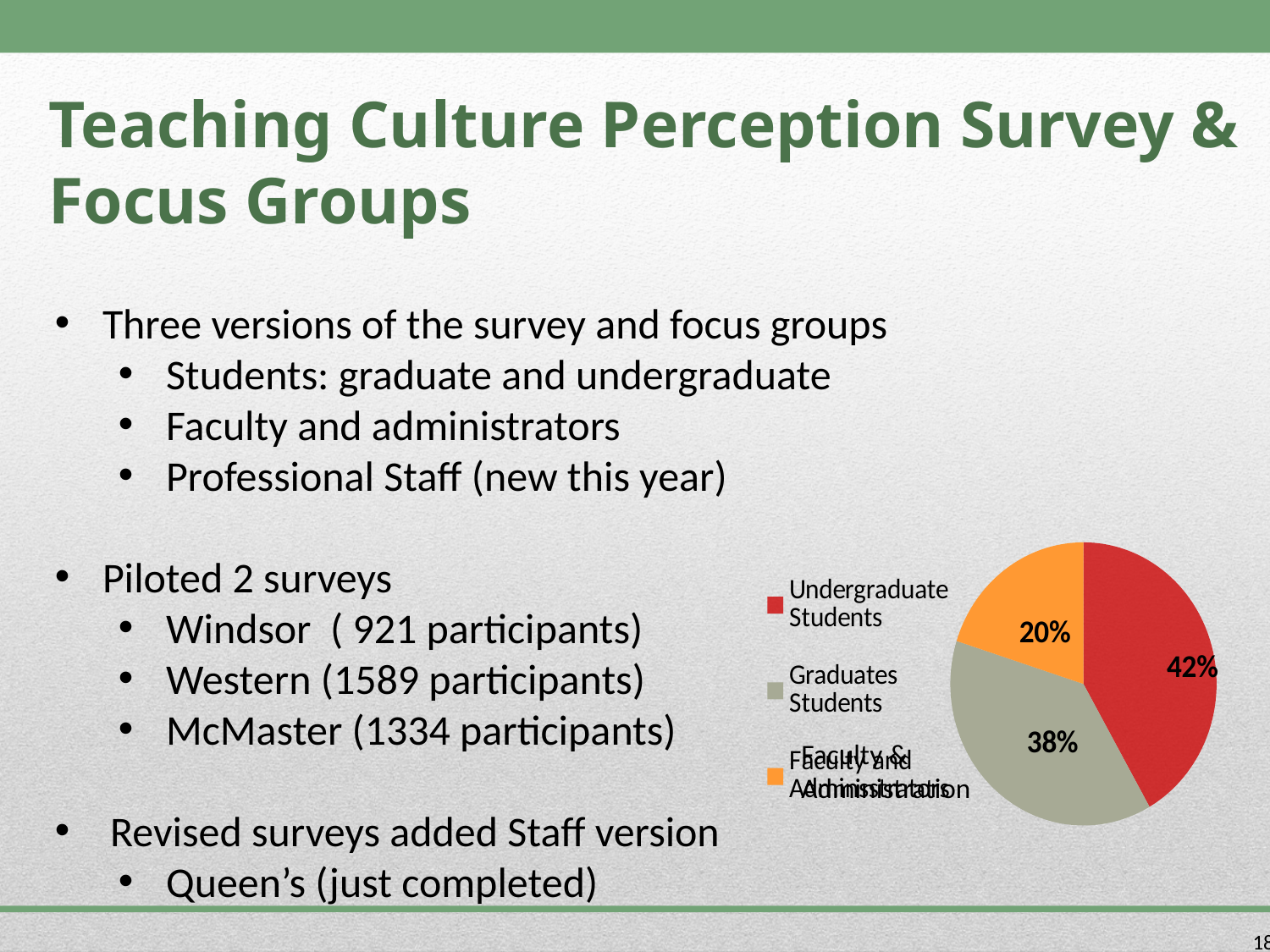
What share of the pie chart is Faculty and Administration? 20% How many entries does the pie chart legend list? 3 What share of the pie chart is Graduates Students? 38% What colour is the Undergraduate Students slice in the pie chart? red What share of the pie chart is Undergraduate Students? 42% Which slice is larger, Graduates Students or Faculty and Administration? Graduates Students What is the difference in percentage points between the Graduates Students slice and the Faculty and Administration slice? 18 Which group has the smallest slice of the pie chart? Faculty and Administration Which group has the largest slice of the pie chart? Undergraduate Students What kind of chart is shown on the slide? pie chart How many slices does the pie chart have? 3 What is the difference in percentage points between the Undergraduate Students slice and the Graduates Students slice? 4